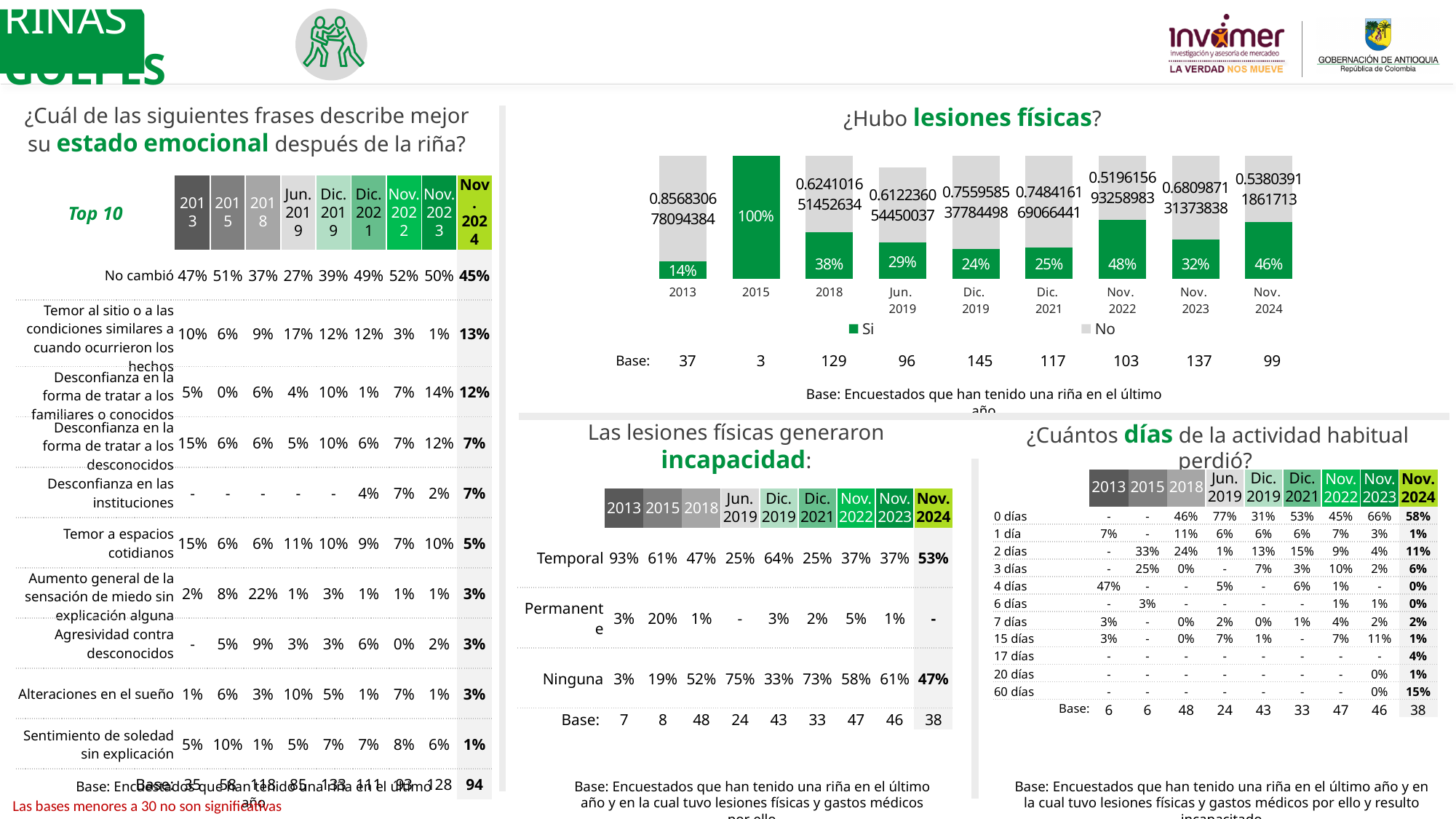
In the chart '¿Hubo lesiones físicas?', what is the difference in percentage points between the 'Si' values for Nov. 2024 and Nov. 2023? 14 percentage points In the chart '¿Hubo lesiones físicas?', what is the 'Si' value for Dic. 2019? 24% How many periods are shown on the x axis of the chart '¿Hubo lesiones físicas?'? 9 In the chart '¿Hubo lesiones físicas?', what is the difference in percentage points between the 'Si' values for Nov. 2022 and Jun. 2019? 19 percentage points How many series does the legend of the chart '¿Hubo lesiones físicas?' list? 2 In the chart '¿Hubo lesiones físicas?', which period has the lowest 'Si' value? 2013 In the chart '¿Hubo lesiones físicas?', which period has the highest 'Si' value? 2015 In the chart '¿Hubo lesiones físicas?', what is the 'Si' value for 2018? 38% In the chart '¿Hubo lesiones físicas?', which has the larger 'Si' value, Dic. 2021 or Nov. 2022? Nov. 2022 What are the legend entries of the chart '¿Hubo lesiones físicas?'? Si, No What kind of chart is '¿Hubo lesiones físicas?'? Stacked bar chart In the chart '¿Hubo lesiones físicas?', what is the 'Si' value for Nov. 2024? 46%